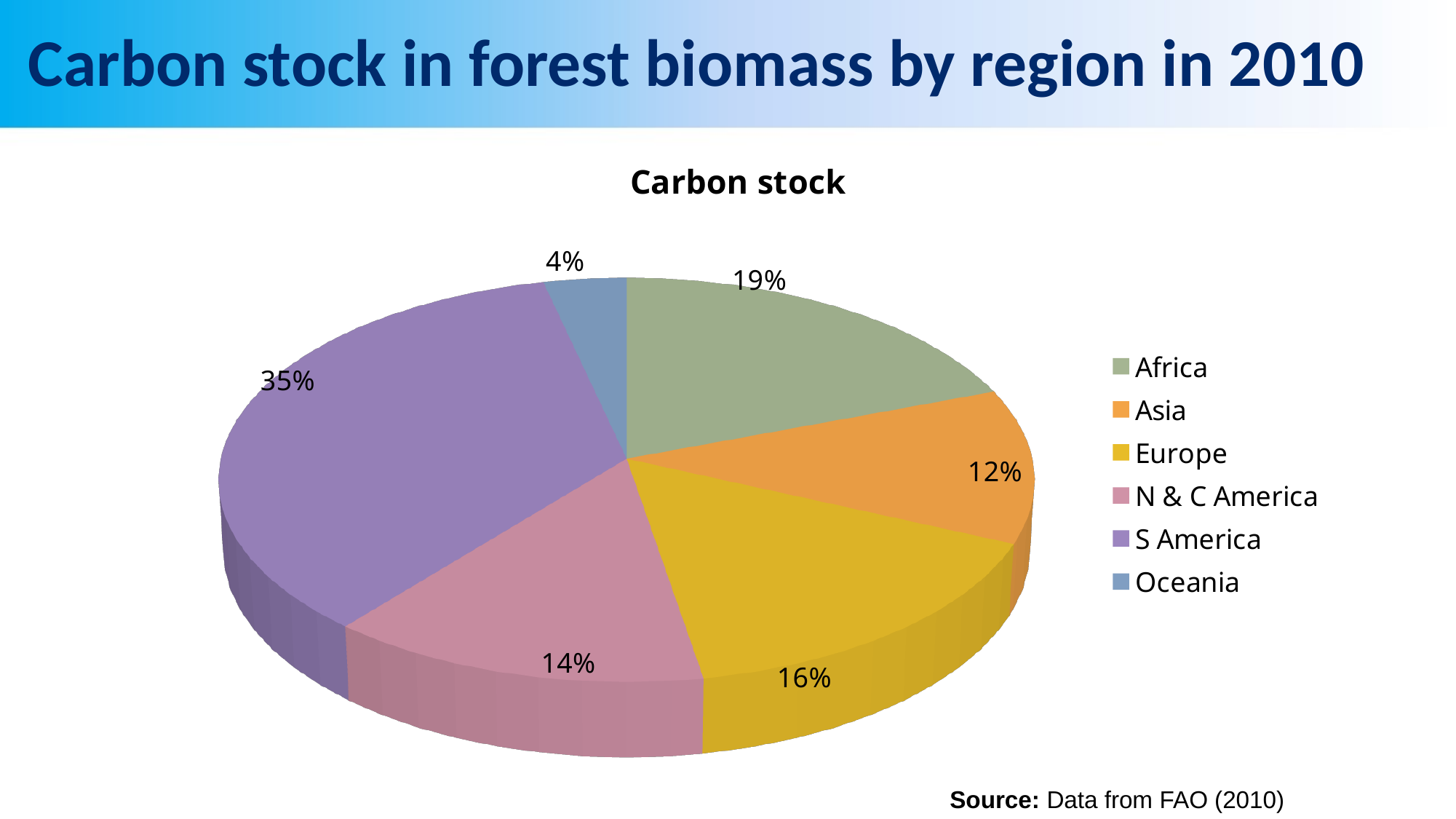
Which region has the largest share of carbon stock? S America What is the difference in percentage points between the S America and Africa shares? 16 What is the title of the chart? Carbon stock Which region has the smallest share of carbon stock? Oceania Which has a larger share of carbon stock, Asia or N & C America? N & C America What share of the carbon stock pie does Europe hold? 16% What share of the carbon stock pie does Africa hold? 19% Which region is shown in yellow in the legend? Europe What kind of chart is shown on the slide? Pie chart How many regions are shown in the pie chart? 6 What share of the carbon stock pie does S America hold? 35%